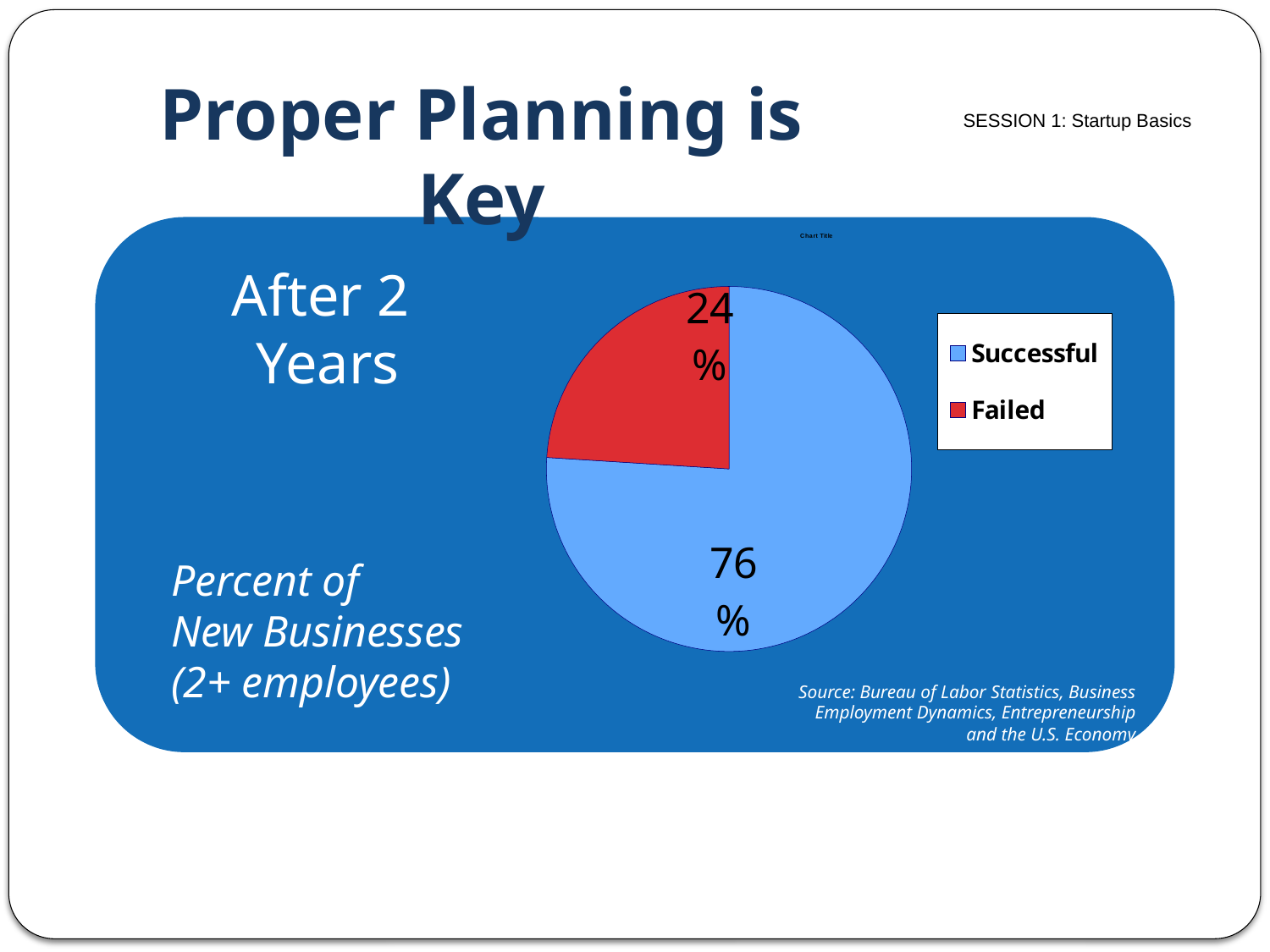
Which slice of the pie is the largest? Successful Which is larger, the Successful slice or the Failed slice? Successful Which slice of the pie is the smallest? Failed What percentage of new businesses Failed after 2 years? 24% What colour is the Failed slice? red What kind of chart is shown on the slide? pie chart What percentage of new businesses were Successful after 2 years? 76% How many entries does the legend list? 2 What is the difference in percentage points between the Successful and Failed slices? 52 What share of the pie does the Failed slice represent? 24% How many slices does the pie chart have? 2 What colour is the Successful slice? blue